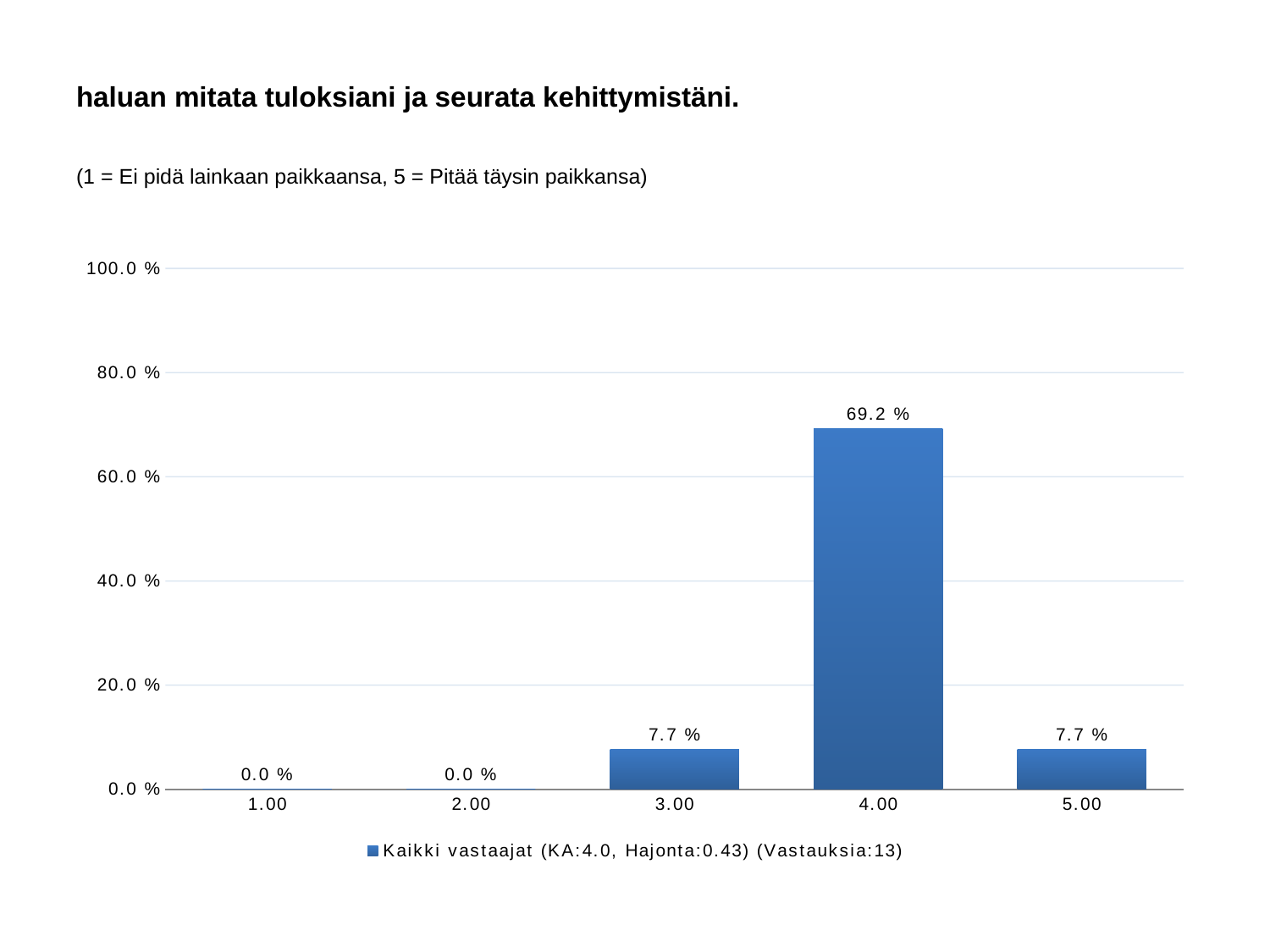
What is the value for category 3.00? 7.7 % Is the value for 4.00 greater or less than 60.0 %? greater Which category has the highest value? 4.00 How many series does the legend list? 1 Which is larger, the value for 4.00 or the value for 5.00? 4.00 What is the value for category 5.00? 7.7 % What kind of chart is shown? bar chart How many categories are shown on the x axis? 5 What is the value for category 4.00? 69.2 % What is the difference between the values for 4.00 and 3.00? 61.5 % What is the value for category 1.00? 0.0 % What is the legend entry for the series? Kaikki vastaajat (KA:4.0, Hajonta:0.43) (Vastauksia:13)